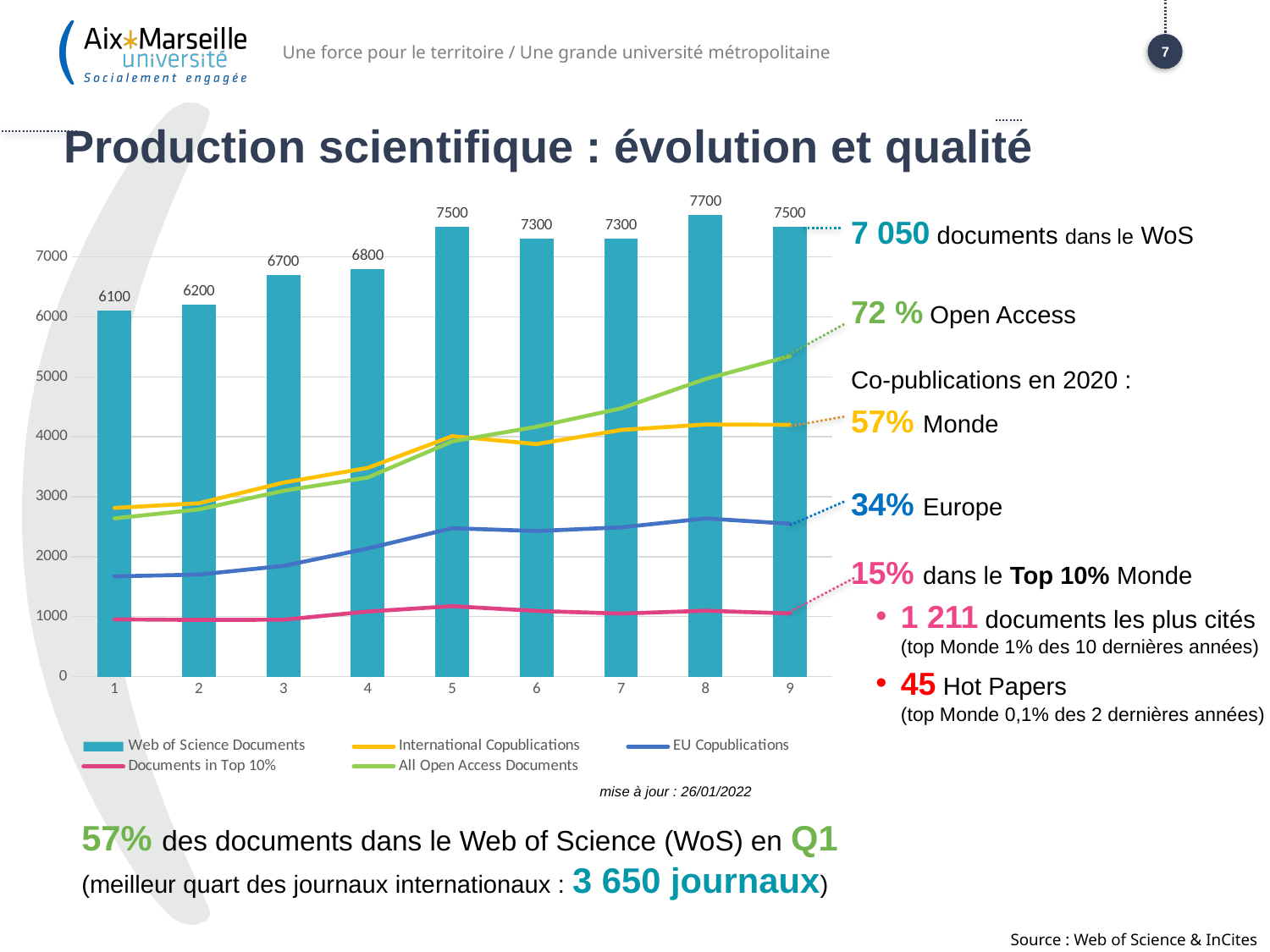
Which category has the lowest value for Web of Science Documents? 1 How many series does the chart legend list? 5 Which category has the highest value for Web of Science Documents? 8 Which has the larger Web of Science Documents value, category 3 or category 4? 4 What kind of chart is shown on the slide? bar and line chart What is the value of Web of Science Documents for category 5? 7500 Is the value for All Open Access Documents at category 9 greater or less than 5000? greater What is the value of Web of Science Documents for category 1? 6100 Is the value for EU Copublications at category 1 greater or less than 2000? less What is the difference between the Web of Science Documents values for category 8 and category 1? 1600 Do the values for All Open Access Documents rise or fall from category 1 to category 9? rise How many categories are shown on the x axis of the chart? 9